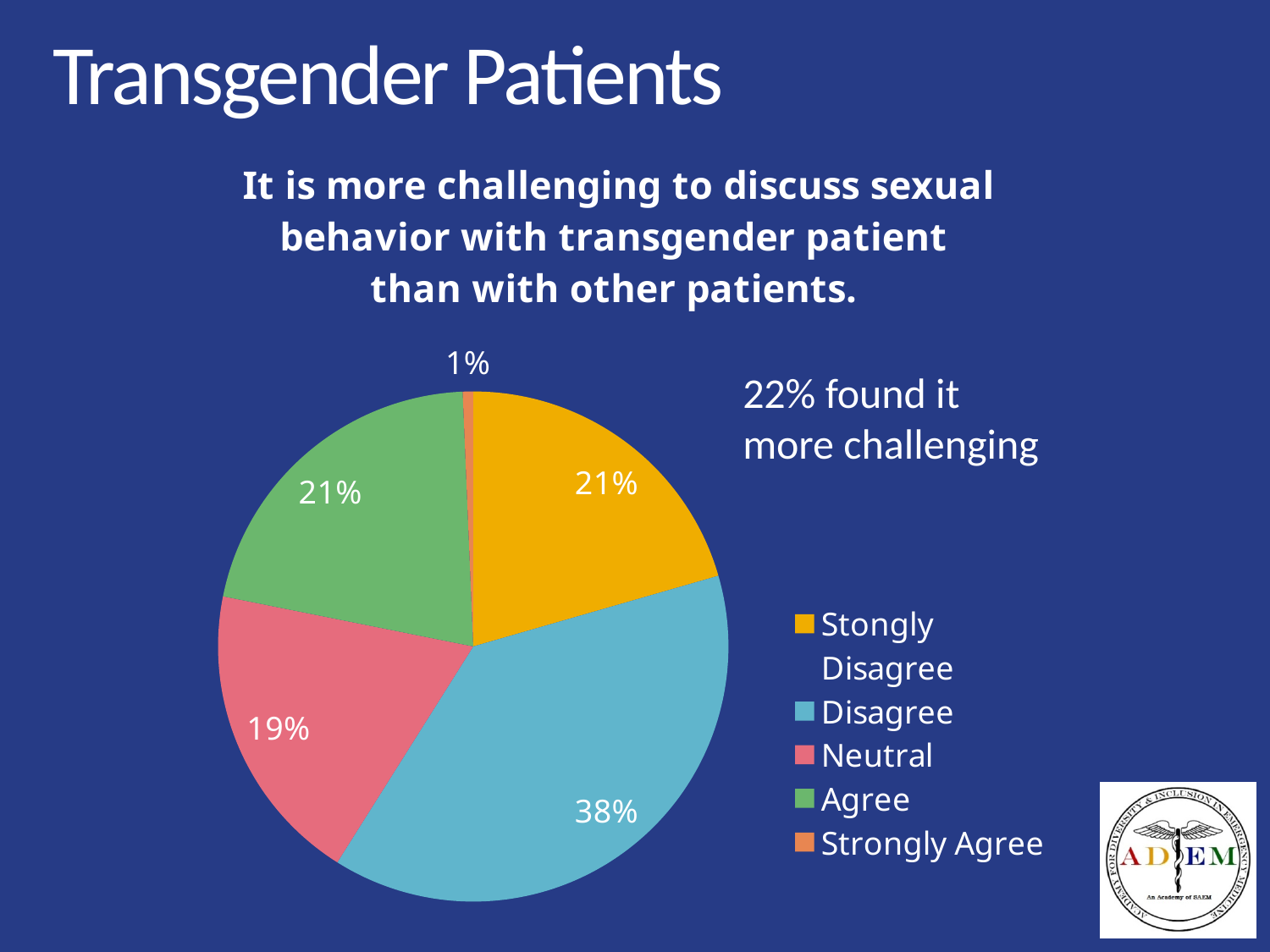
How many slices does the pie chart have? 5 What percentage of respondents chose Disagree? 38% Which is larger, the Neutral share or the Agree share? Agree Which response category has the smallest share of the pie? Strongly Agree What is the combined share of Agree and Strongly Agree? 22% What kind of chart is shown on the slide? pie chart Which response category has the largest share of the pie? Disagree What percentage of respondents chose Neutral? 19% What percentage of respondents chose Agree? 21% How many percentage points larger is the Disagree share than the Neutral share? 19% What percentage of respondents chose Strongly Disagree? 21% What percentage of respondents chose Strongly Agree? 1%